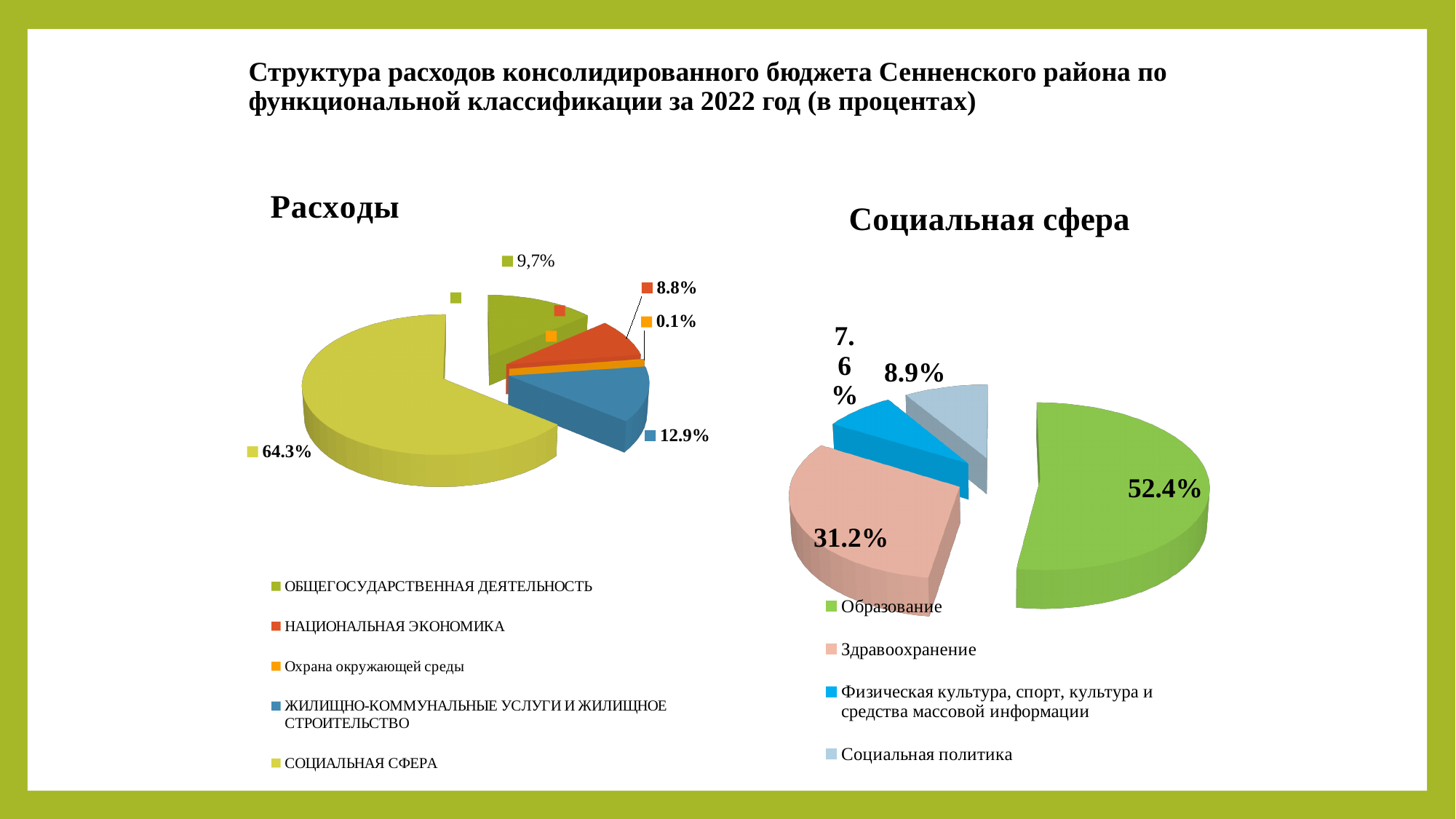
In the "Социальная сфера" chart, what is the value for Здравоохранение? 31.2% In the "Расходы" chart, which is larger: НАЦИОНАЛЬНАЯ ЭКОНОМИКА or ЖИЛИЩНО-КОММУНАЛЬНЫЕ УСЛУГИ И ЖИЛИЩНОЕ СТРОИТЕЛЬСТВО? ЖИЛИЩНО-КОММУНАЛЬНЫЕ УСЛУГИ И ЖИЛИЩНОЕ СТРОИТЕЛЬСТВО In the "Расходы" chart, how many categories does the legend list? 5 In the "Социальная сфера" chart, which category has the largest share? Образование In the "Социальная сфера" chart, what is the value for Физическая культура, спорт, культура и средства массовой информации? 7.6% In the "Расходы" chart, which category has the smallest share? Охрана окружающей среды In the "Расходы" chart, what is the value for ЖИЛИЩНО-КОММУНАЛЬНЫЕ УСЛУГИ И ЖИЛИЩНОЕ СТРОИТЕЛЬСТВО? 12.9% What type of chart is the "Социальная сфера" chart? Pie chart In the "Расходы" chart, what is the difference between the values for ЖИЛИЩНО-КОММУНАЛЬНЫЕ УСЛУГИ И ЖИЛИЩНОЕ СТРОИТЕЛЬСТВО and НАЦИОНАЛЬНАЯ ЭКОНОМИКА? 4.1% In the "Социальная сфера" chart, what is the value for Образование? 52.4% In the "Расходы" chart, what is the value for СОЦИАЛЬНАЯ СФЕРА? 64.3% In the "Расходы" chart, what is the value for Охрана окружающей среды? 0.1%